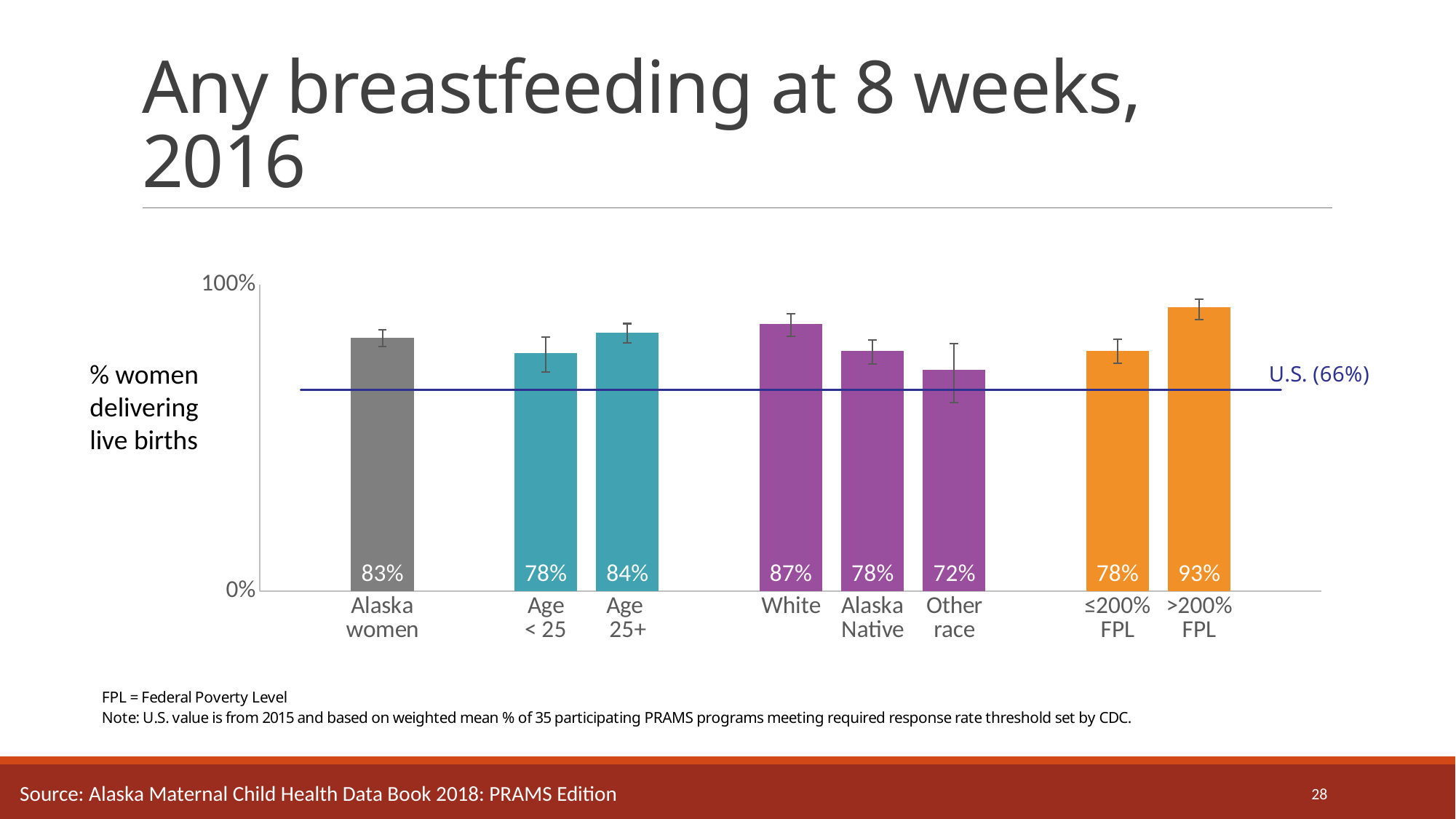
What is the difference between the value for >200% FPL and the value for ≤200% FPL? 15% Which category has the highest value? >200% FPL What U.S. value is marked by the horizontal reference line? 66% What is the value for >200% FPL? 93% How many bars are shown in the chart? 8 Which category has the lowest value? Other race What is the label on the y axis of the chart? % women delivering live births What is the value for Alaska women? 83% What is the value for Other race? 72% What kind of chart is shown on the slide? Bar chart What is the difference between the values for White and Alaska Native? 9% Which is larger, the value for Age < 25 or the value for Age 25+? Age 25+